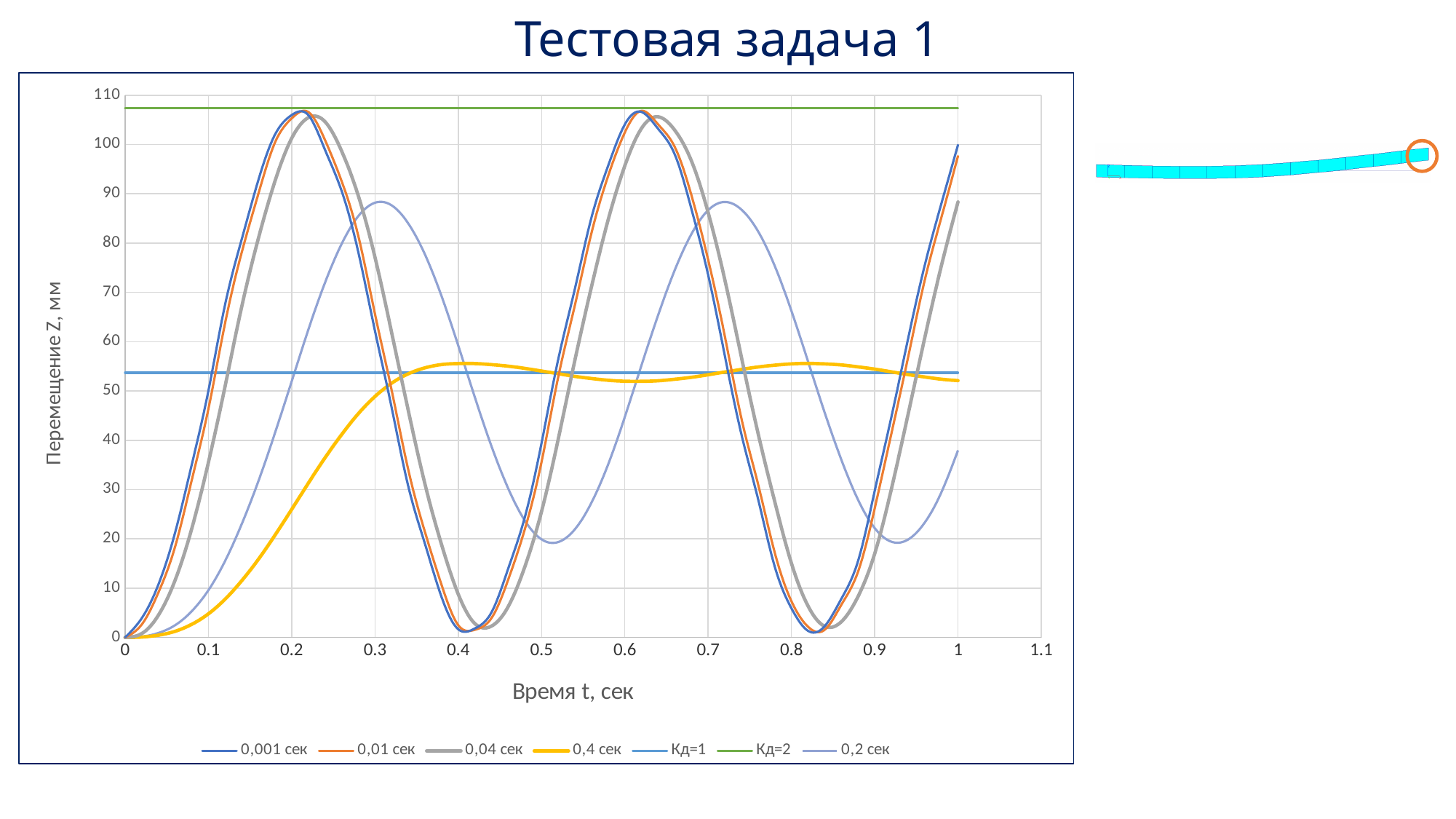
Is the value of the horizontal Кд=2 line greater or less than 100? greater What is the title of the slide above the chart? Тестовая задача 1 Is the maximum value reached by the 0,4 сек series greater or less than 60? less Is the first peak of the 0,2 сек series greater or less than 80? greater Does the 0,4 сек series rise or fall between t = 0 and t = 0.3? rise What kind of chart is shown on the slide? line chart How many series does the legend list? 7 What is the label of the horizontal axis? Время t, сек Which series reaches a higher first peak, 0,001 сек or 0,2 сек? 0,001 сек